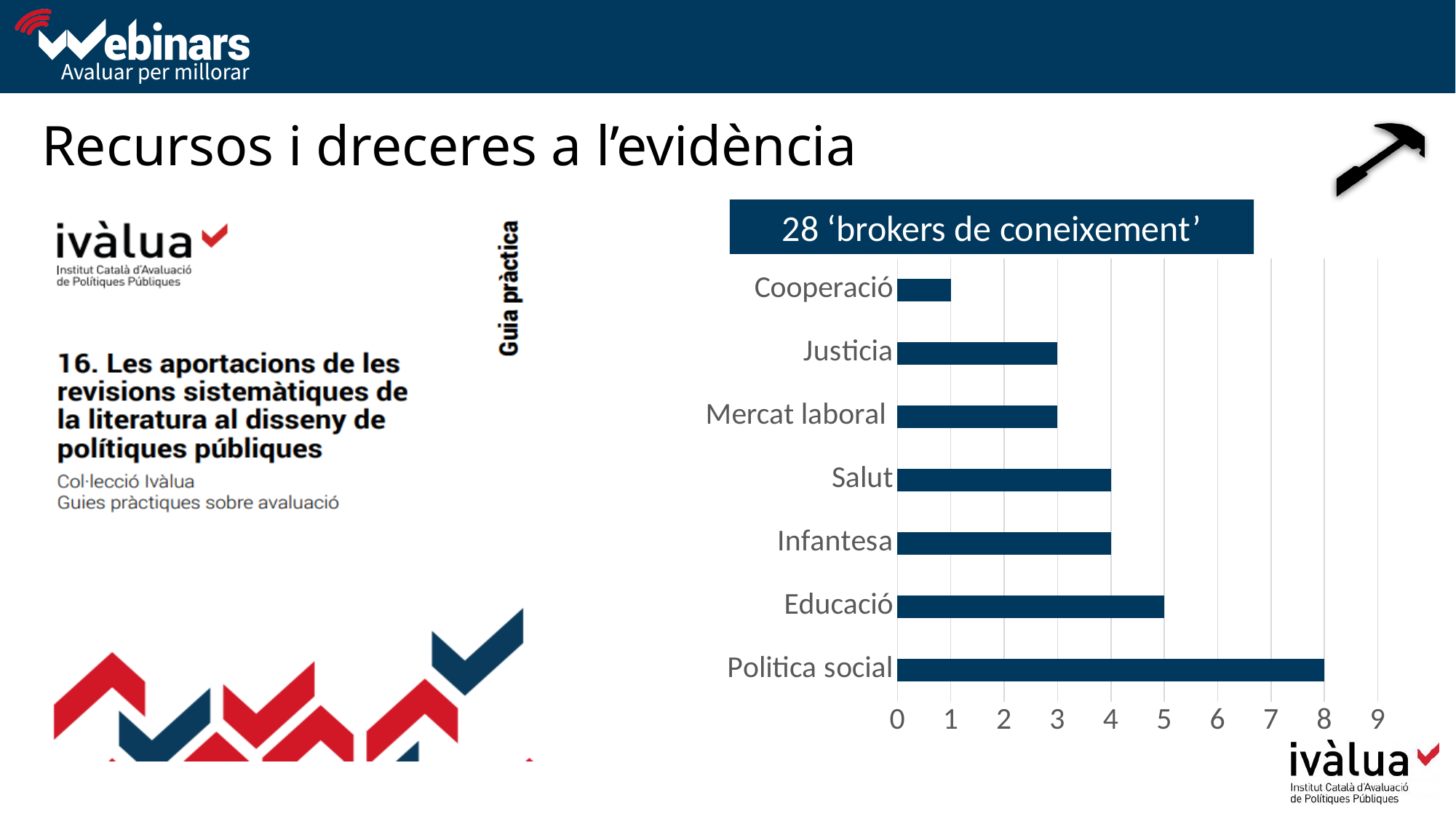
What kind of chart is shown on the slide? bar chart Which category has the lowest value? Cooperació What is the value for Politica social? 8 Is the value for Mercat laboral greater or less than 5? less What is the title of the chart? 28 'brokers de coneixement' What is the value for Cooperació? 1 Which category has the highest value? Politica social Which is larger, the value for Infantesa or the value for Justicia? Infantesa What is the difference between the values for Politica social and Educació? 3 How many categories does the chart show? 7 What is the value for Salut? 4 What is the value for Educació? 5